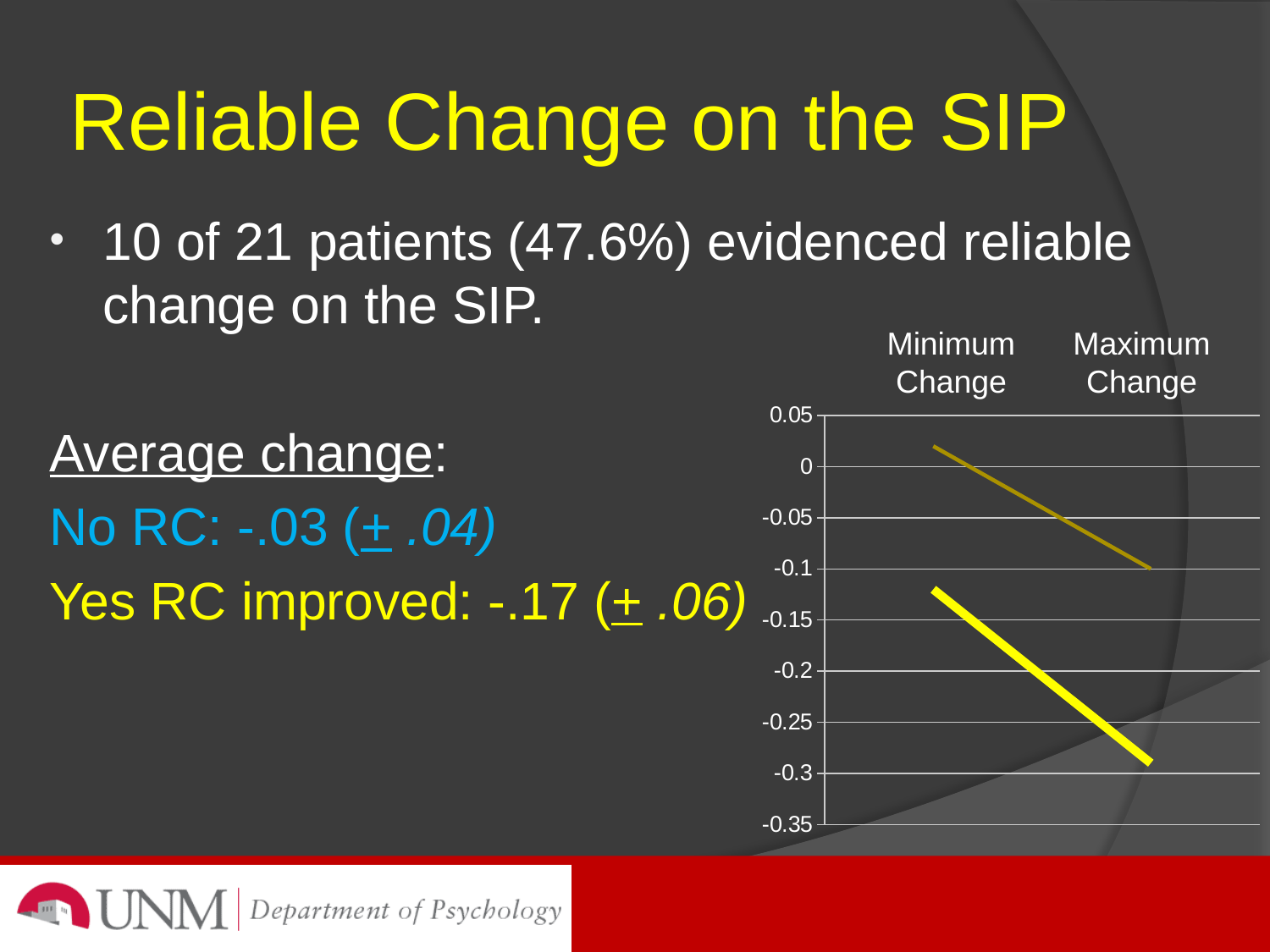
At Minimum Change, which line is lower on the chart, the bright yellow line or the dark olive line? the bright yellow line How many categories are shown on the x axis of the chart? 2 What are the two category labels on the x axis of the chart? Minimum Change and Maximum Change Is the value of the bright yellow line at Maximum Change greater or less than -0.2? less Do the lines on the chart rise or fall from Minimum Change to Maximum Change? fall How many lines are plotted on the chart? 2 What kind of chart is shown on the slide? line chart What is the lowest tick value shown on the y axis of the chart? -0.35 Is the value of the dark olive line at Maximum Change greater or less than -0.15? greater At Maximum Change, which line is higher on the chart, the bright yellow line or the dark olive line? the dark olive line Is the value of the dark olive line at Minimum Change greater or less than -0.05? greater